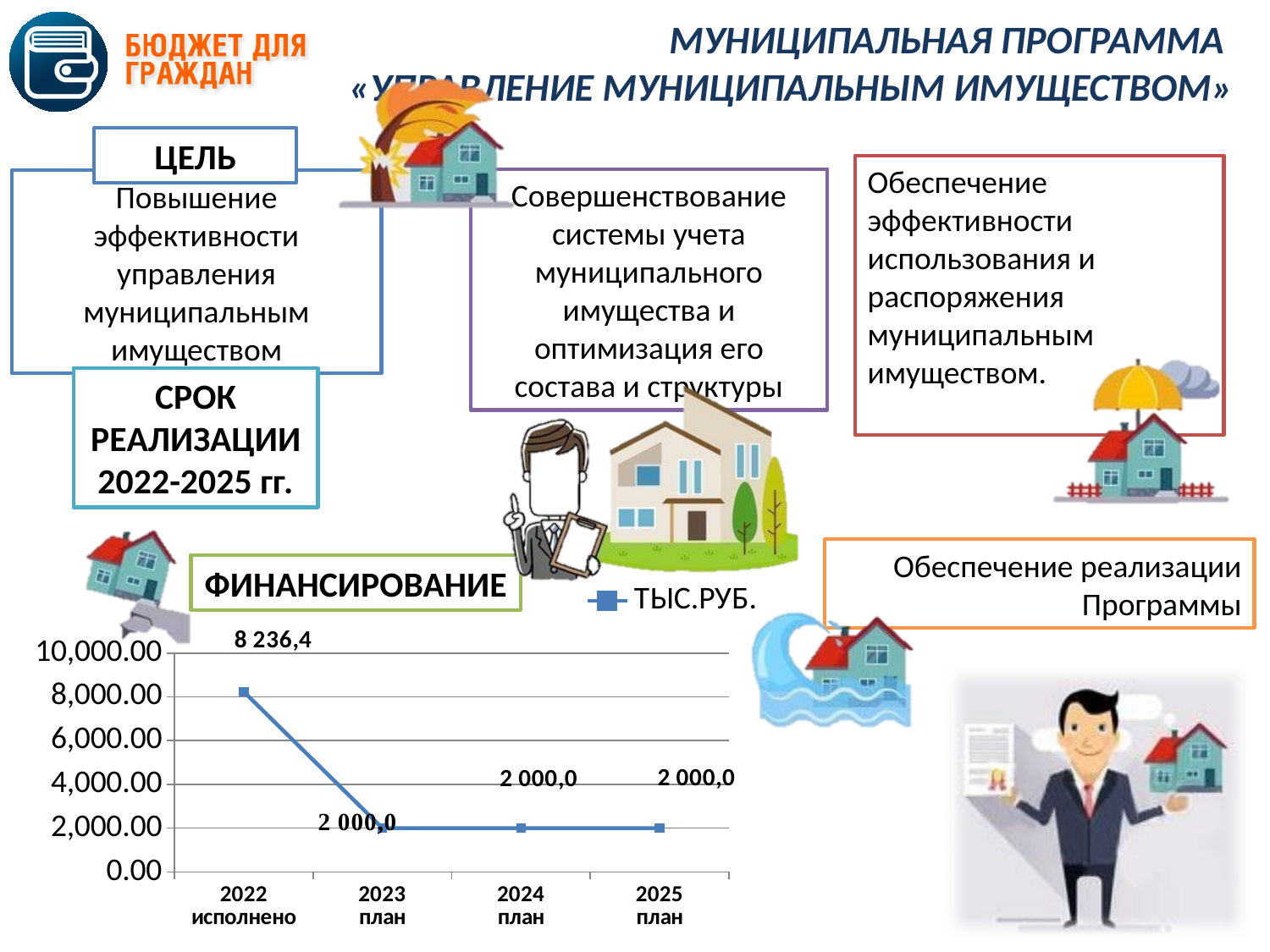
What is the value for 2025 план? 2 000,0 Is the value for 2022 исполнено greater or less than 6,000.00? greater What is the difference between the values for 2022 исполнено and 2023 план? 6 236,4 What is the value for 2023 план? 2 000,0 How many series does the chart legend list? 1 Which category has the highest value? 2022 исполнено Which is larger, the value for 2022 исполнено or the value for 2024 план? 2022 исполнено What is the value for 2022 исполнено? 8 236,4 Is the value for 2024 план greater or less than 4,000.00? less Do the values rise or fall from 2022 исполнено to 2023 план? fall What type of chart is shown on the slide? line chart How many categories are shown on the x axis of the chart? 4